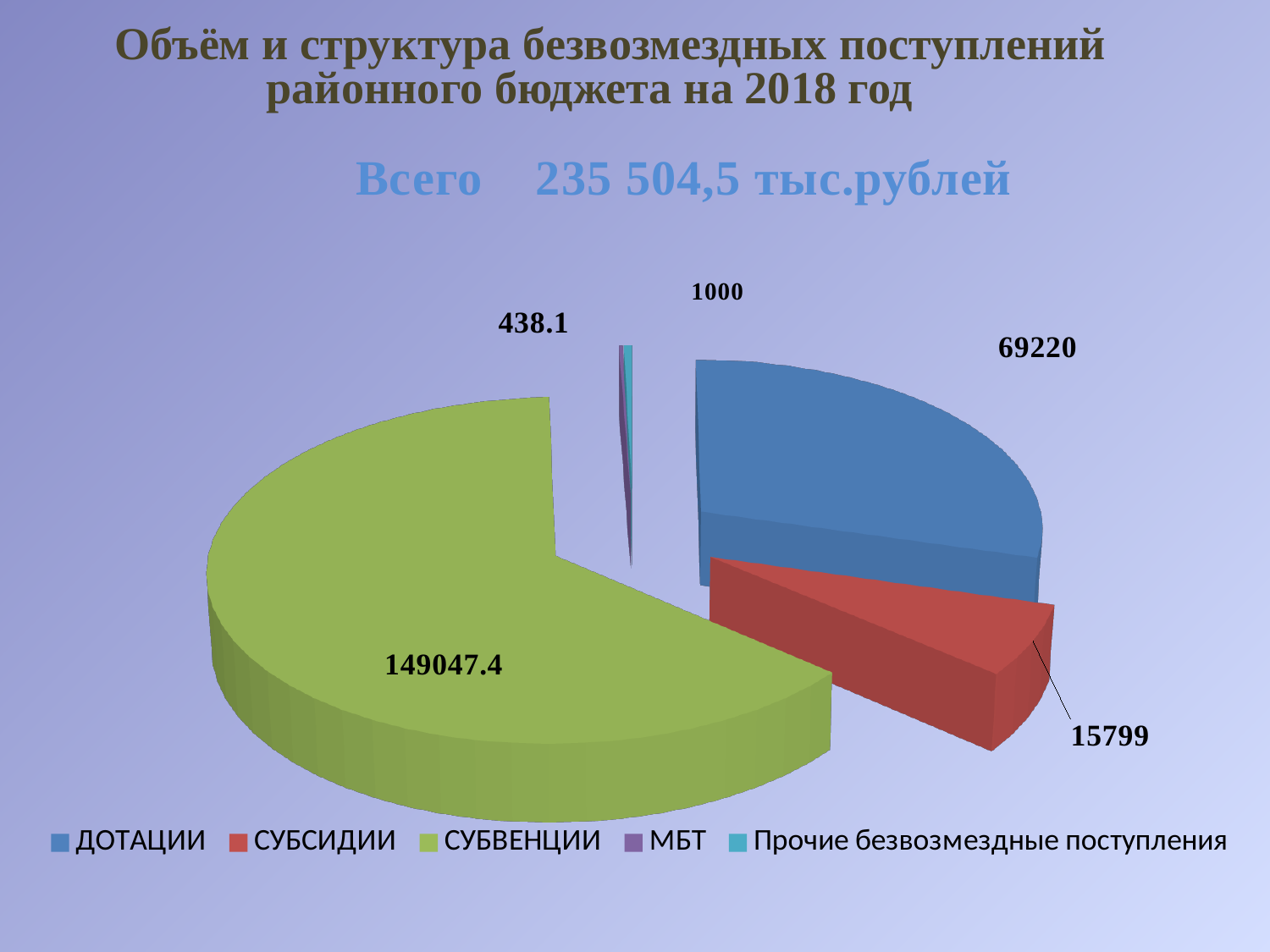
Which is larger, the value for ДОТАЦИИ or the value for СУБСИДИИ? ДОТАЦИИ What total is stated on the slide for all gratuitous receipts? 235 504,5 тыс.рублей What is the value for СУБСИДИИ? 15799 What type of chart is shown on the slide? Pie chart Which category has the smallest slice of the pie? МБТ What is the value for ДОТАЦИИ? 69220 What is the difference between the values for СУБВЕНЦИИ and ДОТАЦИИ? 79827.4 Which category has the largest slice of the pie? СУБВЕНЦИИ How many categories does the legend list? 5 What is the value for СУБВЕНЦИИ? 149047.4 What is the difference between the values for ДОТАЦИИ and СУБСИДИИ? 53421 What share of the pie does СУБВЕНЦИИ represent? 63.3%